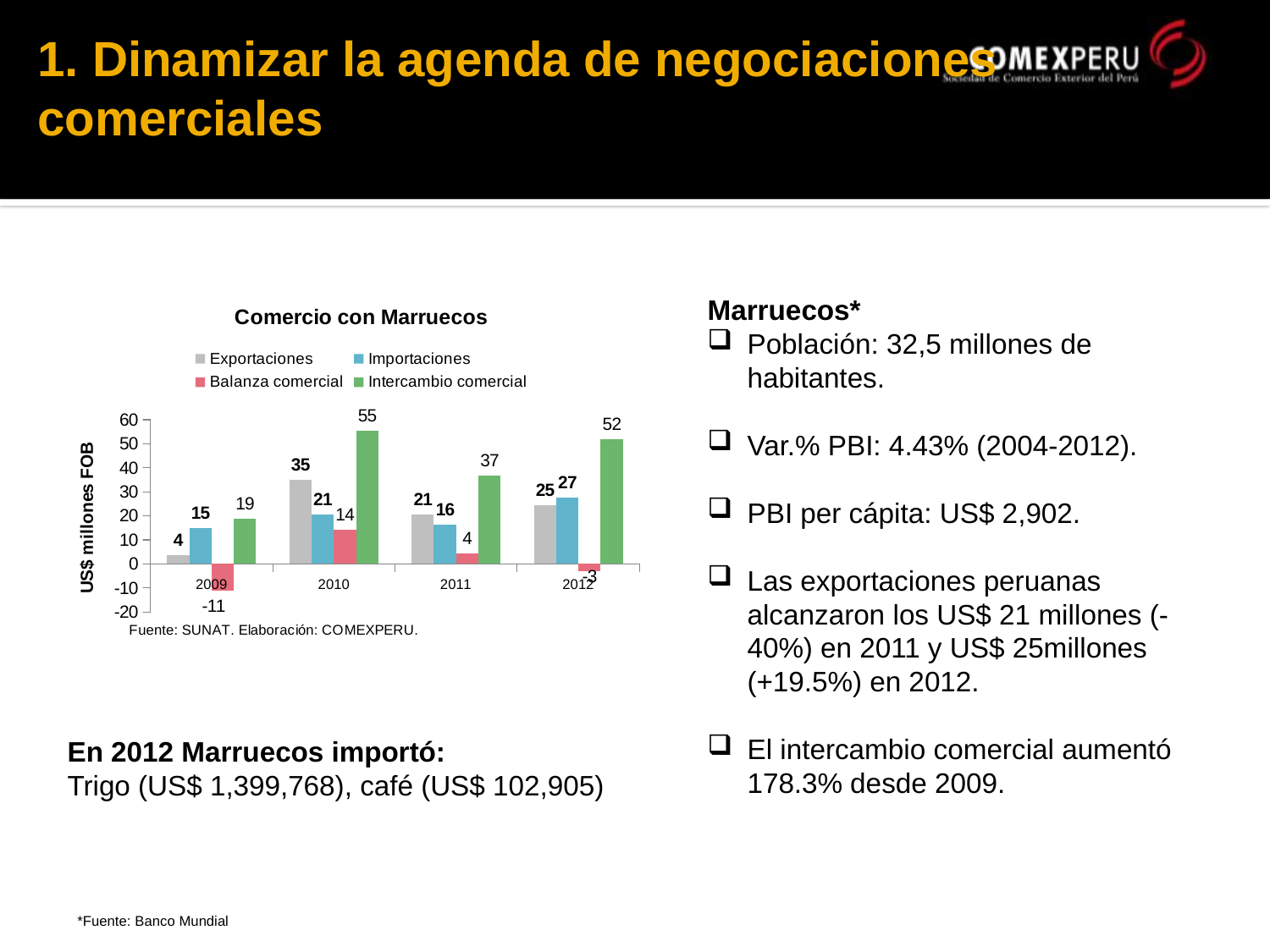
How many series does the legend list? 4 In which year was Exportaciones highest? 2010 What is the value of Importaciones in 2012? 27 What is the value of Balanza comercial in 2009? -11 What is the value of Exportaciones in 2009? 4 What is the difference between Intercambio comercial in 2010 and in 2011? 18 How many years are shown on the x axis? 4 In which year was Intercambio comercial lowest? 2009 Which was larger in 2012, Exportaciones or Importaciones? Importaciones What kind of chart is this? Bar chart What is the value of Intercambio comercial in 2010? 55 What is the title of the chart? Comercio con Marruecos